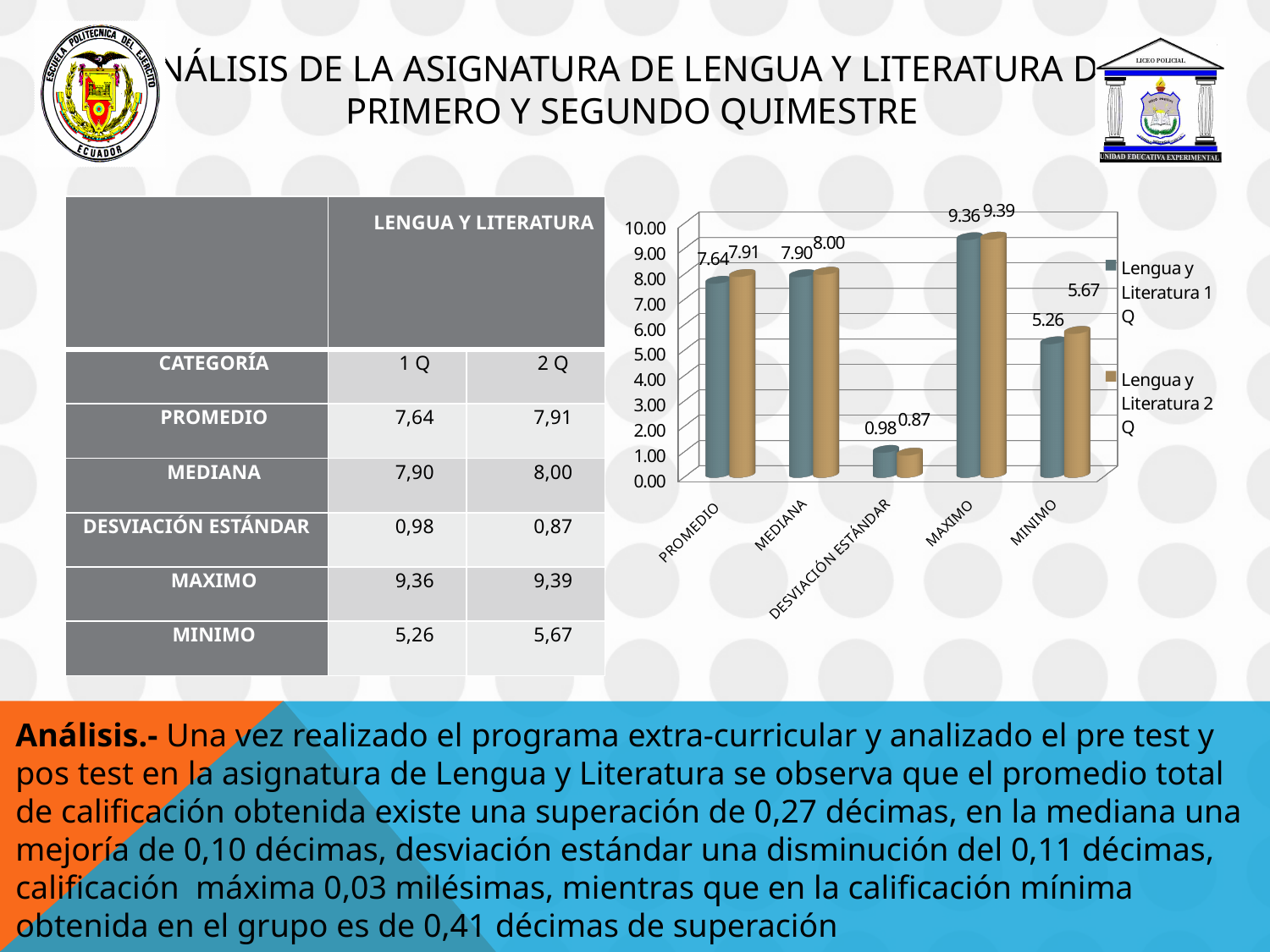
How many series does the chart legend list? 2 What is the value for MINIMO in the Lengua y Literatura 1 Q series? 5.26 What is the value for MEDIANA in the Lengua y Literatura 2 Q series? 8.00 What is the difference between the Lengua y Literatura 2 Q and Lengua y Literatura 1 Q values for MINIMO? 0.41 What is the value for DESVIACIÓN ESTÁNDAR in the Lengua y Literatura 2 Q series? 0.87 What is the value for PROMEDIO in the Lengua y Literatura 1 Q series? 7.64 How many categories are shown on the x axis of the chart? 5 What kind of chart is shown on the slide? bar chart Which category has the lowest value in the Lengua y Literatura 1 Q series? DESVIACIÓN ESTÁNDAR Which category has the highest value in the Lengua y Literatura 2 Q series? MAXIMO Is the value for MAXIMO in the Lengua y Literatura 1 Q series greater or less than 9.00? greater For DESVIACIÓN ESTÁNDAR, which series has the larger value, Lengua y Literatura 1 Q or Lengua y Literatura 2 Q? Lengua y Literatura 1 Q